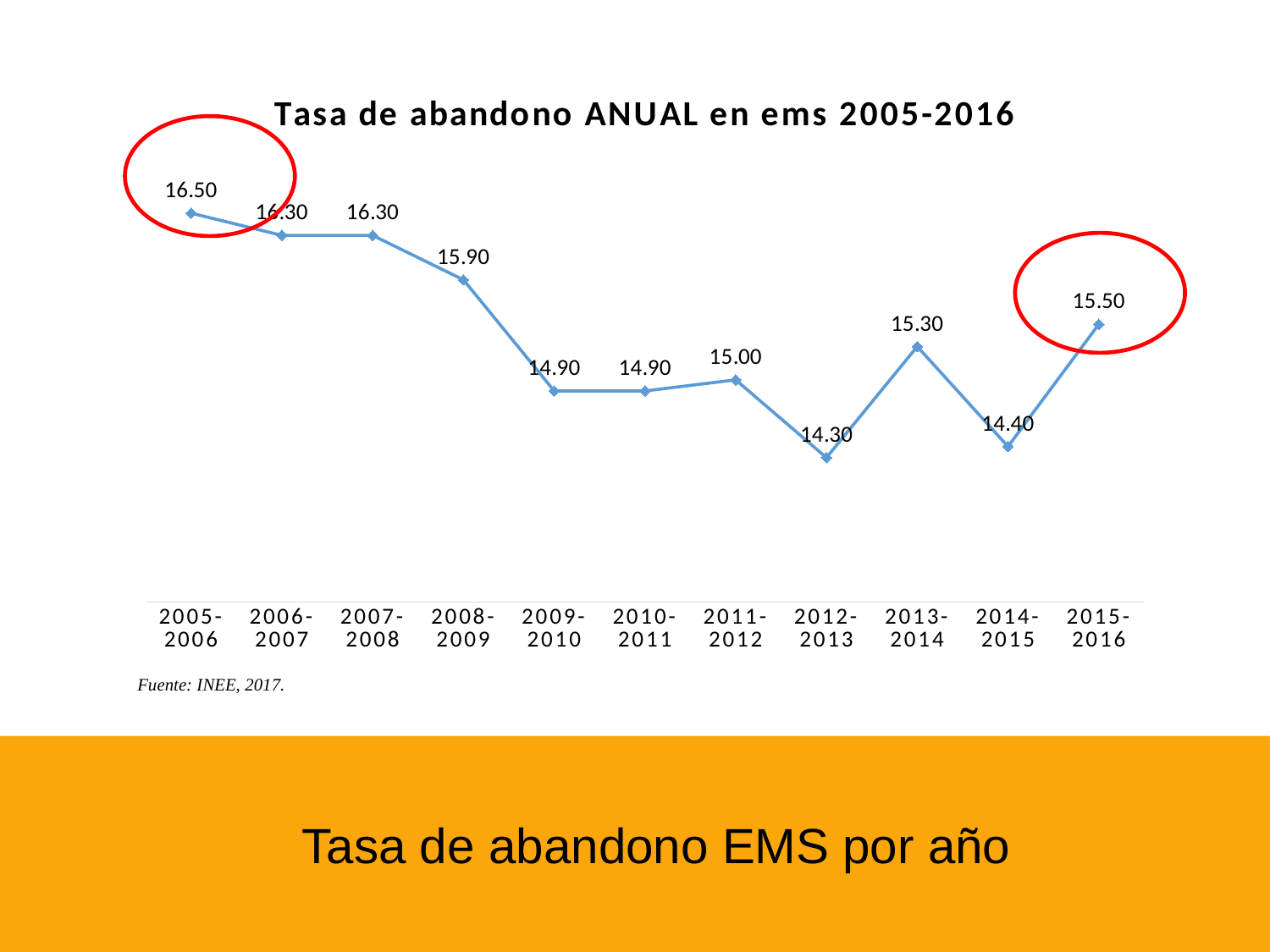
What is the title of the chart? Tasa de abandono ANUAL en ems 2005-2016 What kind of chart is shown? Line chart What is the value for 2008-2009? 15.90 How many periods are plotted on the chart? 11 What is the value for 2005-2006? 16.50 Which period has the lowest value? 2012-2013 What is the value for 2012-2013? 14.30 Which period has the highest value? 2005-2006 What is the value for 2015-2016? 15.50 What is the difference between the values for 2005-2006 and 2015-2016? 1.00 Which is larger, the value for 2011-2012 or the value for 2013-2014? 2013-2014 What is the difference between the values for 2013-2014 and 2014-2015? 0.90